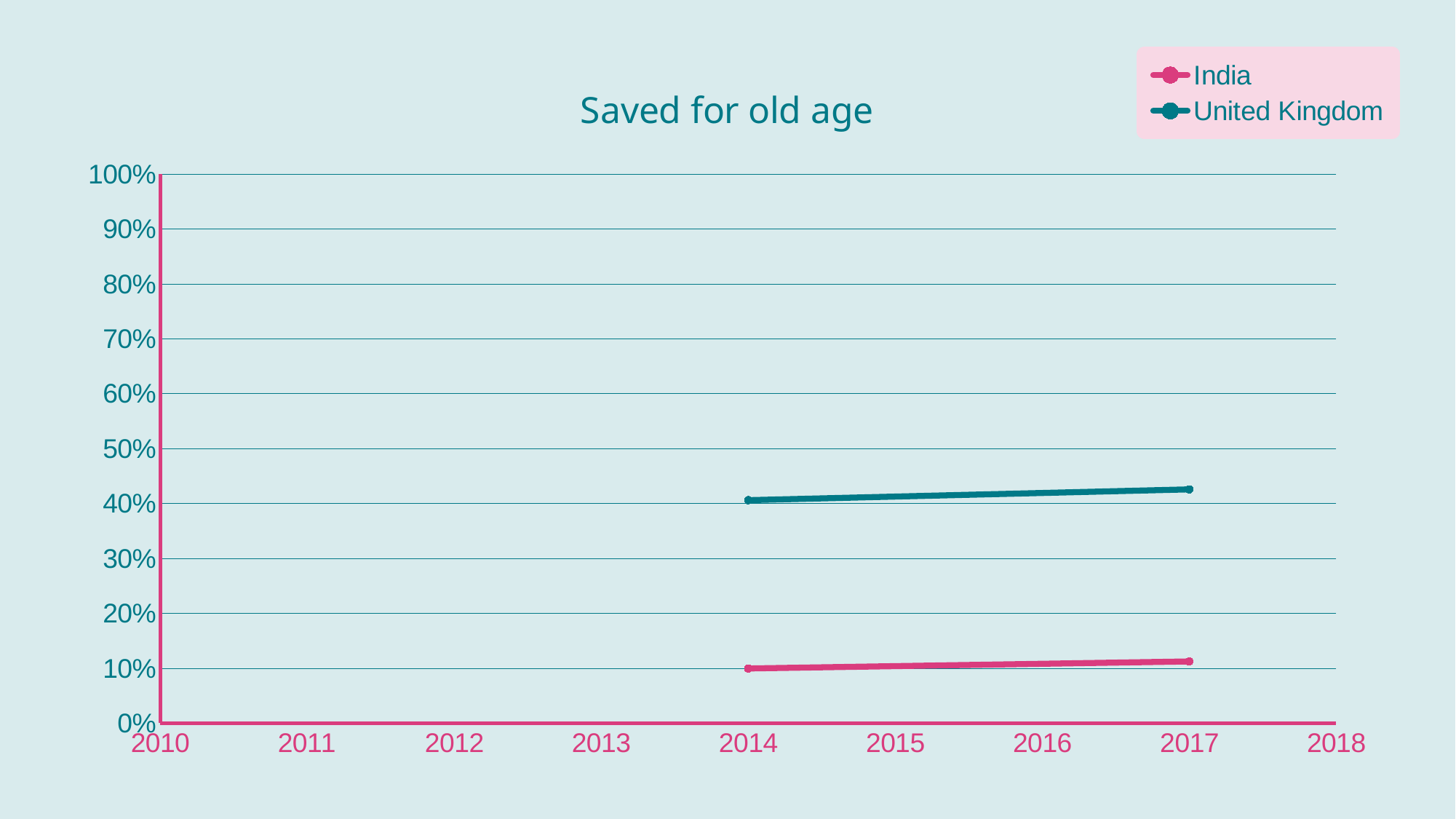
What is the title of the chart? Saved for old age How many data points are plotted for the United Kingdom series? 2 What kind of chart is shown on the slide? line chart Does the United Kingdom series rise or fall from 2014 to 2017? rise Does the India series rise or fall from 2014 to 2017? rise Is the value for the United Kingdom in 2017 greater or less than 30%? greater Which series has the higher value in 2017, India or United Kingdom? United Kingdom Is the value for India in 2017 greater or less than 20%? less Which series has the lower value in 2014? India Is the value for the United Kingdom in 2017 greater or less than 50%? less Which series is drawn in pink? India How many series does the legend list? 2